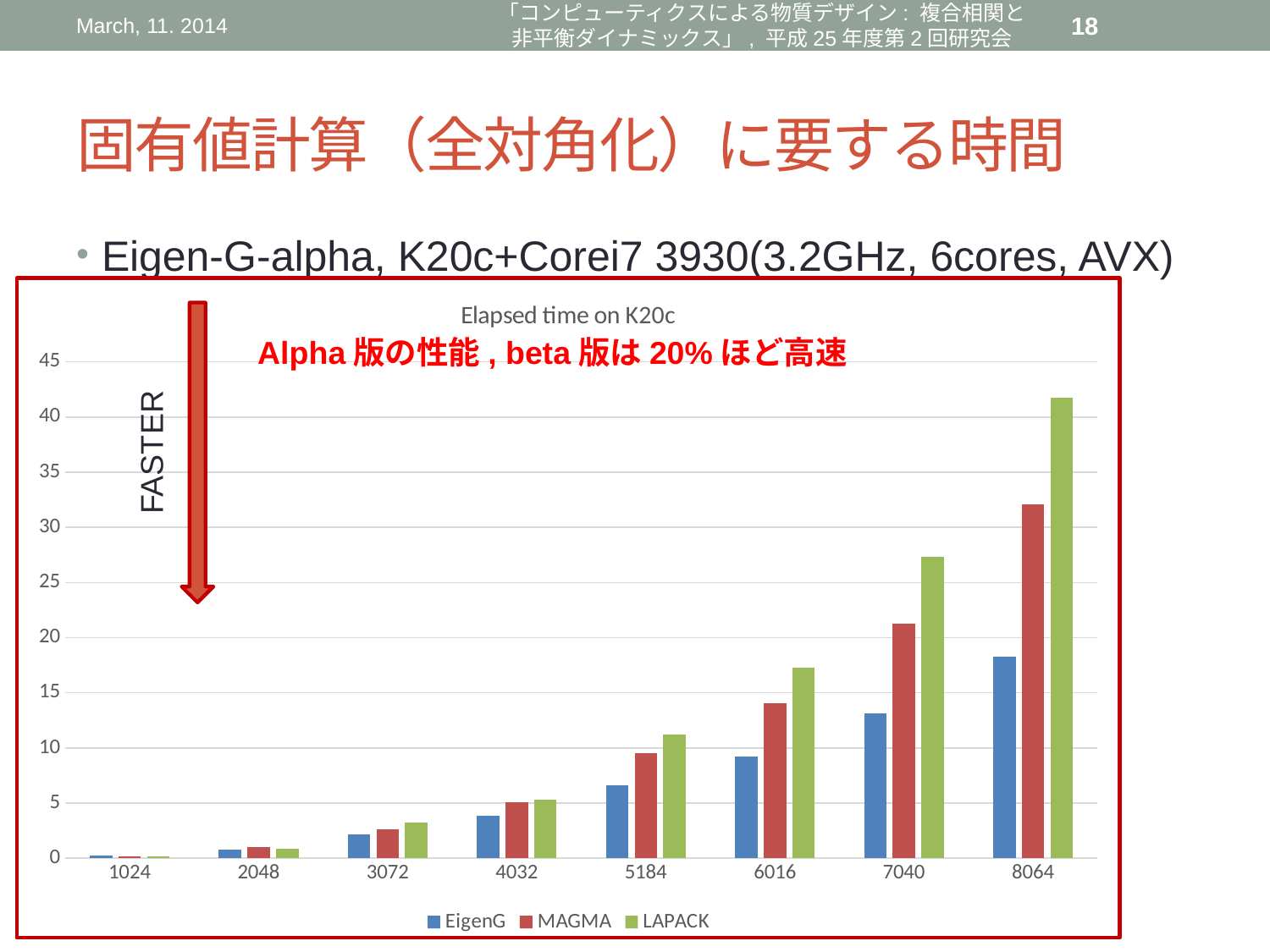
How many categories are shown along the x axis of the chart? 8 Is the EigenG value at 8064 greater or less than 20? less Which series has the shortest bar at 8064? EigenG How many series does the chart legend list? 3 At 7040, which is larger: the MAGMA value or the LAPACK value? LAPACK Is the MAGMA value at 7040 greater or less than 20? greater What kind of chart is shown on the slide? bar chart Do the elapsed times rise or fall as the matrix size increases along the x axis? rise What is the title of the chart? Elapsed time on K20c Is the EigenG value at 6016 greater or less than 10? less Which series has the tallest bar at 8064? LAPACK